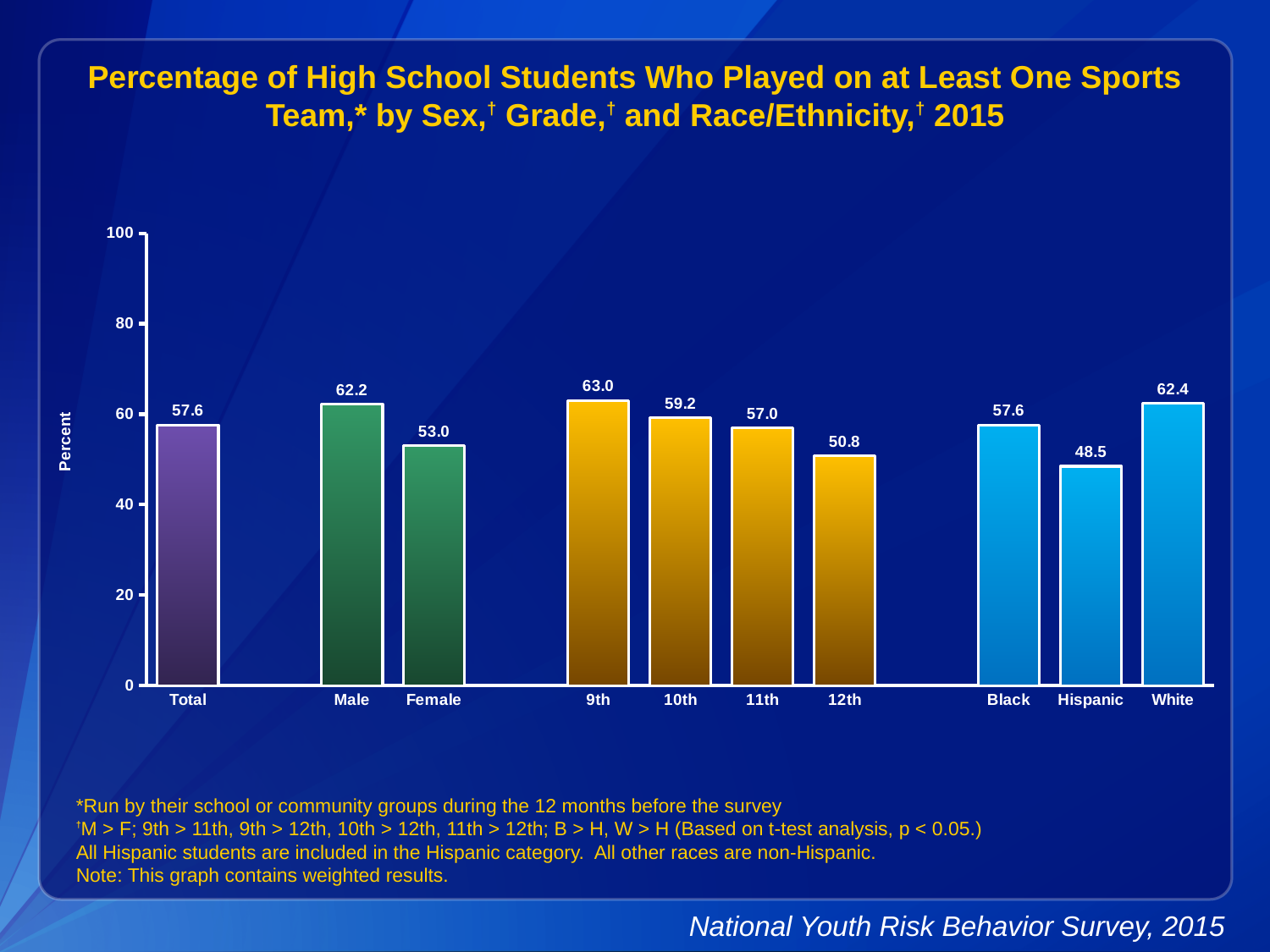
What is the difference between the Male and Female values? 9.2 Which category has the highest value? 9th Is the value for 10th grade greater or less than 40? greater Which is larger, the value for White or the value for Black? White Which category has the lowest value? Hispanic What kind of chart is this? bar chart Do the values rise or fall from 9th grade to 12th grade? fall What is the value for Hispanic? 48.5 How many bars are shown in the chart? 10 What is the value for Male? 62.2 What is the value for 12th grade? 50.8 What is the label of the y axis? Percent